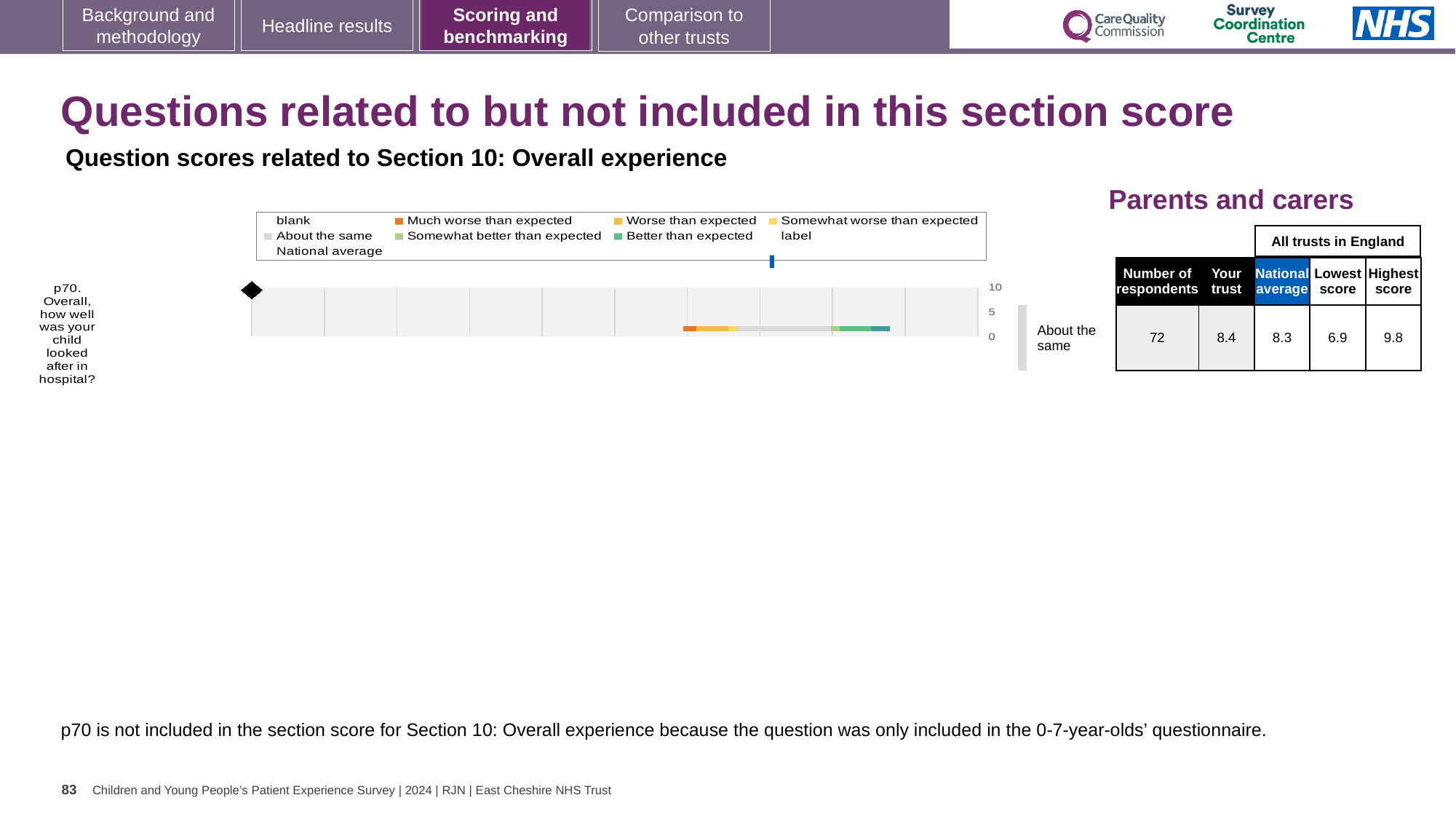
In the table beside the chart, what is the national average score for p70? 8.3 In the table beside the chart, which is larger for p70: the 'Your trust' score or the national average? Your trust What is the highest value shown on the chart's axis? 10 In the table beside the chart, what is the lowest score among all trusts in England for p70? 6.9 In the table beside the chart, what is the difference between the highest and lowest scores for p70? 2.9 Which legend entry is shown in orange? Much worse than expected What benchmark category label is shown to the right of the p70 bar? About the same In the table beside the chart, what is the highest score among all trusts in England for p70? 9.8 What kind of chart is shown for question p70? bar chart How many questions (categories) are plotted in the chart? 1 In the table beside the chart, how many respondents answered p70? 72 In the table beside the chart, what is the 'Your trust' score for p70? 8.4